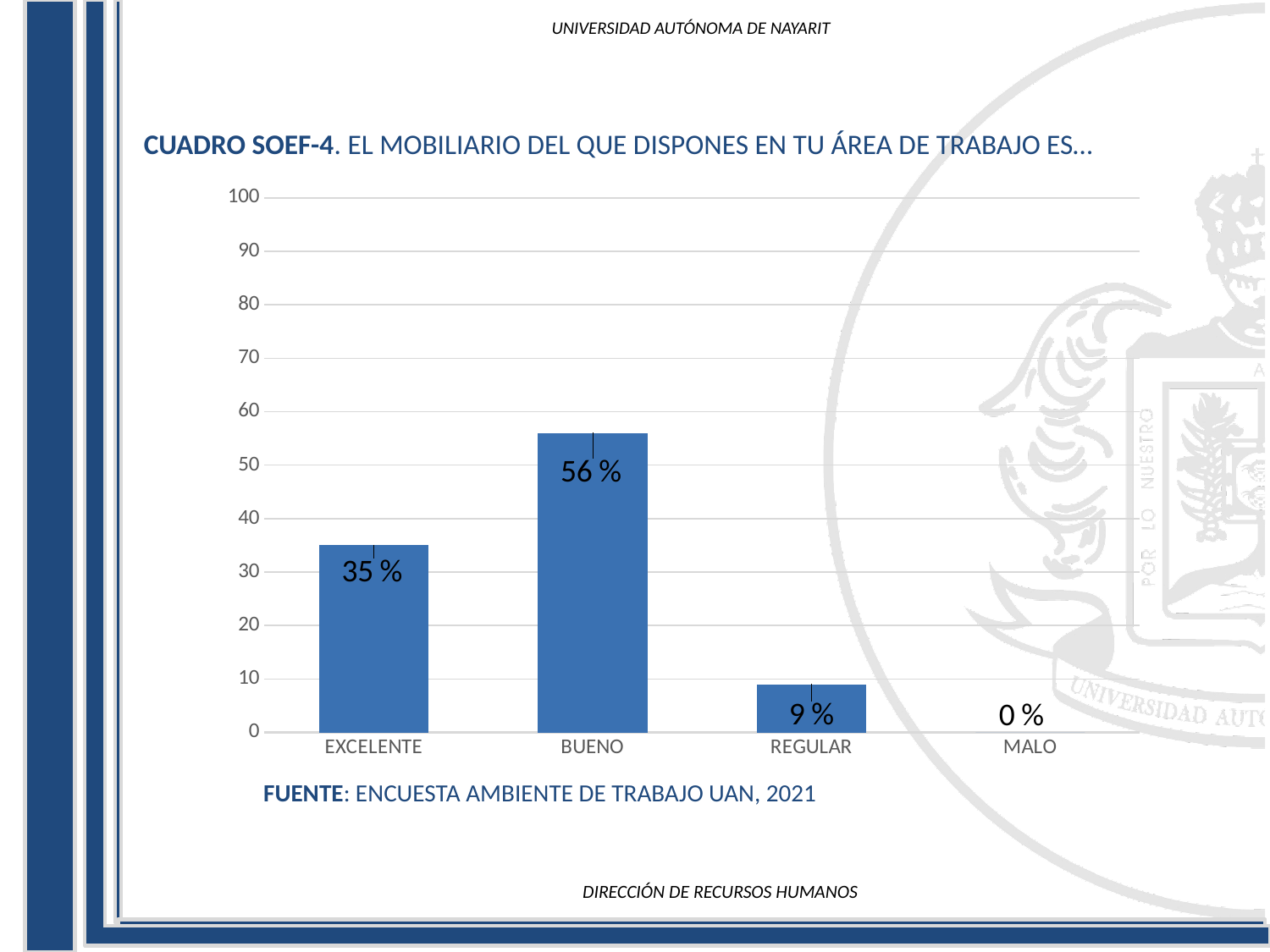
What is the source cited below the chart? ENCUESTA AMBIENTE DE TRABAJO UAN, 2021 What is the value for REGULAR? 9 % Which is larger, the value for EXCELENTE or the value for REGULAR? EXCELENTE Which category has the highest value? BUENO What is the difference between the values for BUENO and EXCELENTE? 21 % What kind of chart is shown on the slide? bar chart Which category has the lowest value? MALO What is the value for MALO? 0 % Is the value for BUENO greater or less than 50? greater What is the value for EXCELENTE? 35 % How many categories are shown on the x axis? 4 What is the value for BUENO? 56 %